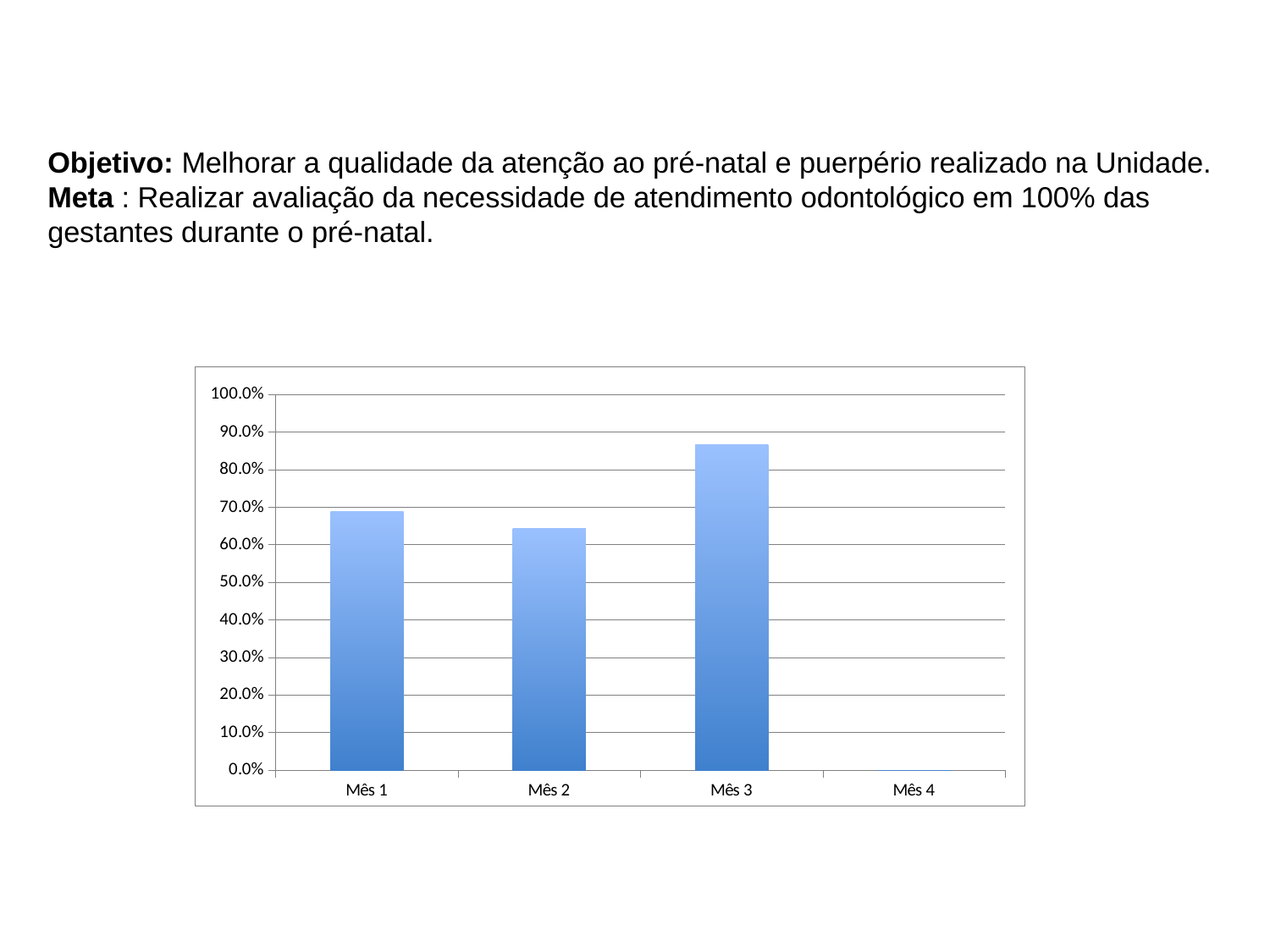
Which month has the lowest value in the chart? Mês 4 How many categories are shown on the x axis of the chart? 4 Which is larger, the value for Mês 3 or the value for Mês 1? Mês 3 Is the value for Mês 4 greater or less than 10.0%? less Is the value for Mês 3 greater or less than 80.0%? greater Which is larger, the value for Mês 1 or the value for Mês 2? Mês 1 Is the value for Mês 2 greater or less than 60.0%? greater Does the value rise or fall from Mês 2 to Mês 3? rise What is the highest value shown on the y axis of the chart? 100.0% Which month has the highest value in the chart? Mês 3 What kind of chart is shown on the slide? bar chart